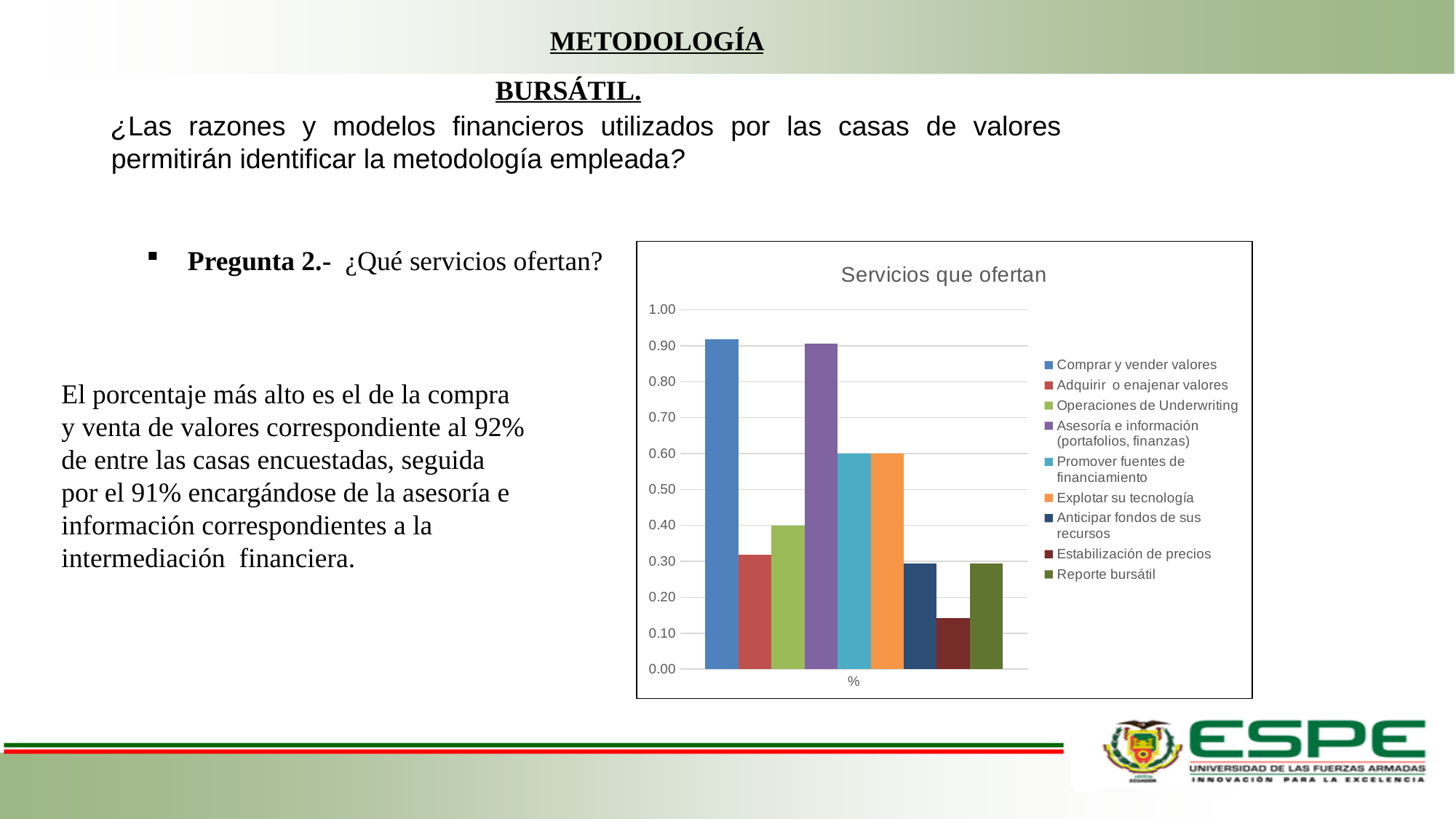
Is the value for Adquirir o enajenar valores greater or less than 0.40? less What is the value for Operaciones de Underwriting? 0.40 What is the title of the chart? Servicios que ofertan Which is larger, the value for Operaciones de Underwriting or the value for Adquirir o enajenar valores? Operaciones de Underwriting What is the value for Explotar su tecnología? 0.60 What kind of chart is shown on the slide? bar chart How many series does the chart legend list? 9 Which service has the lowest value in the chart? Estabilización de precios Is the value for Estabilización de precios greater or less than 0.20? less What is the value for Promover fuentes de financiamiento? 0.60 Is the value for Comprar y vender valores greater or less than 0.80? greater Which is larger, the value for Asesoría e información (portafolios, finanzas) or the value for Promover fuentes de financiamiento? Asesoría e información (portafolios, finanzas)